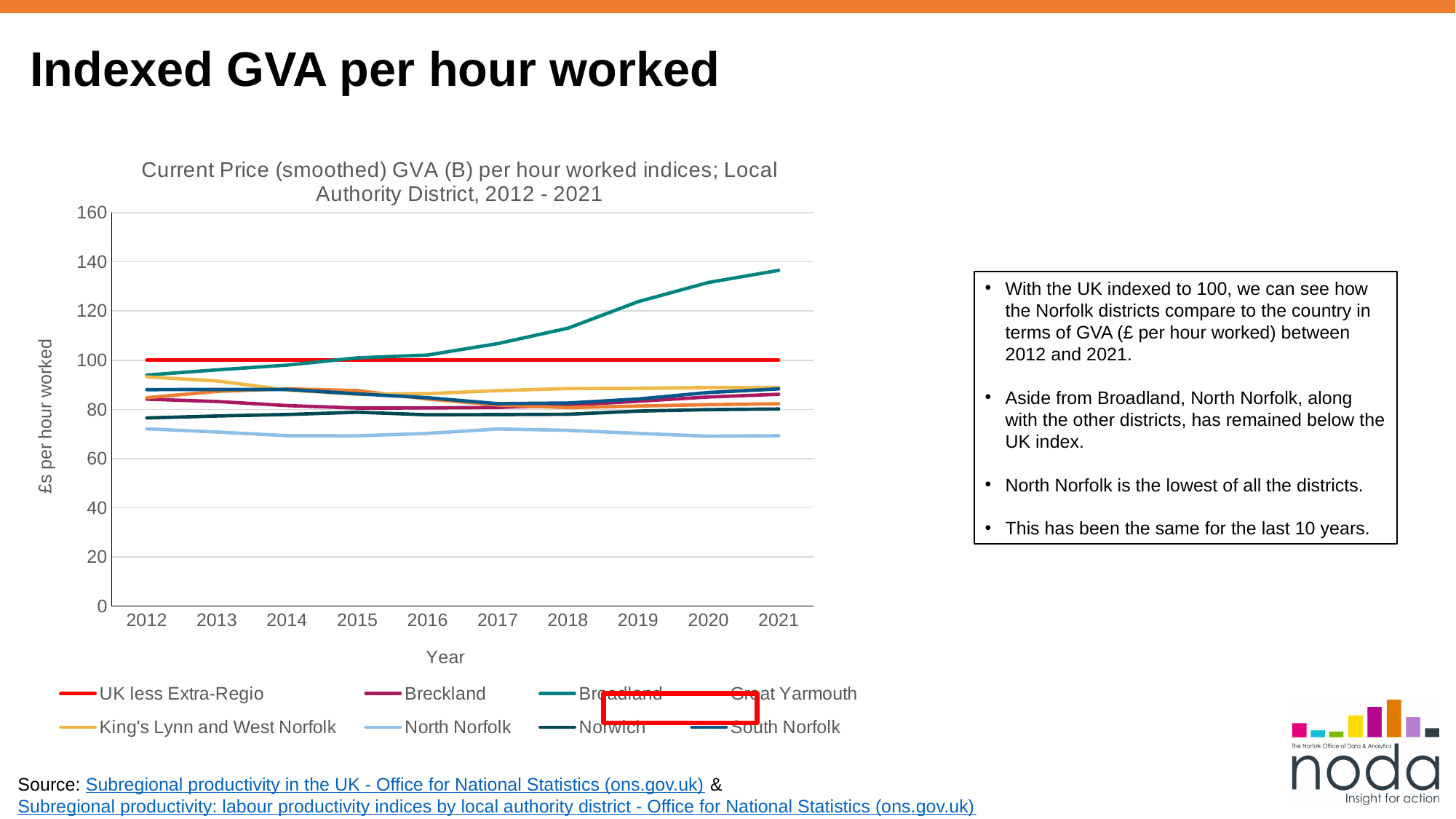
What value does the UK less Extra-Regio line sit at across all years? 100 Which series has the highest value in 2021? Broadland Does the Broadland line rise or fall from 2012 to 2021? rises Is the value for North Norfolk in 2021 greater or less than 80? less Is the value for Broadland in 2021 greater or less than 120? greater How many years are plotted along the x axis? 10 Which is larger in 2021, the value for Broadland or the value for North Norfolk? Broadland How many series does the chart's legend list? 8 What kind of chart is shown on the slide? line chart Is the value for Breckland in 2012 greater or less than 100? less Which series has the lowest value in 2021? North Norfolk What is the label on the y axis of the chart? £s per hour worked